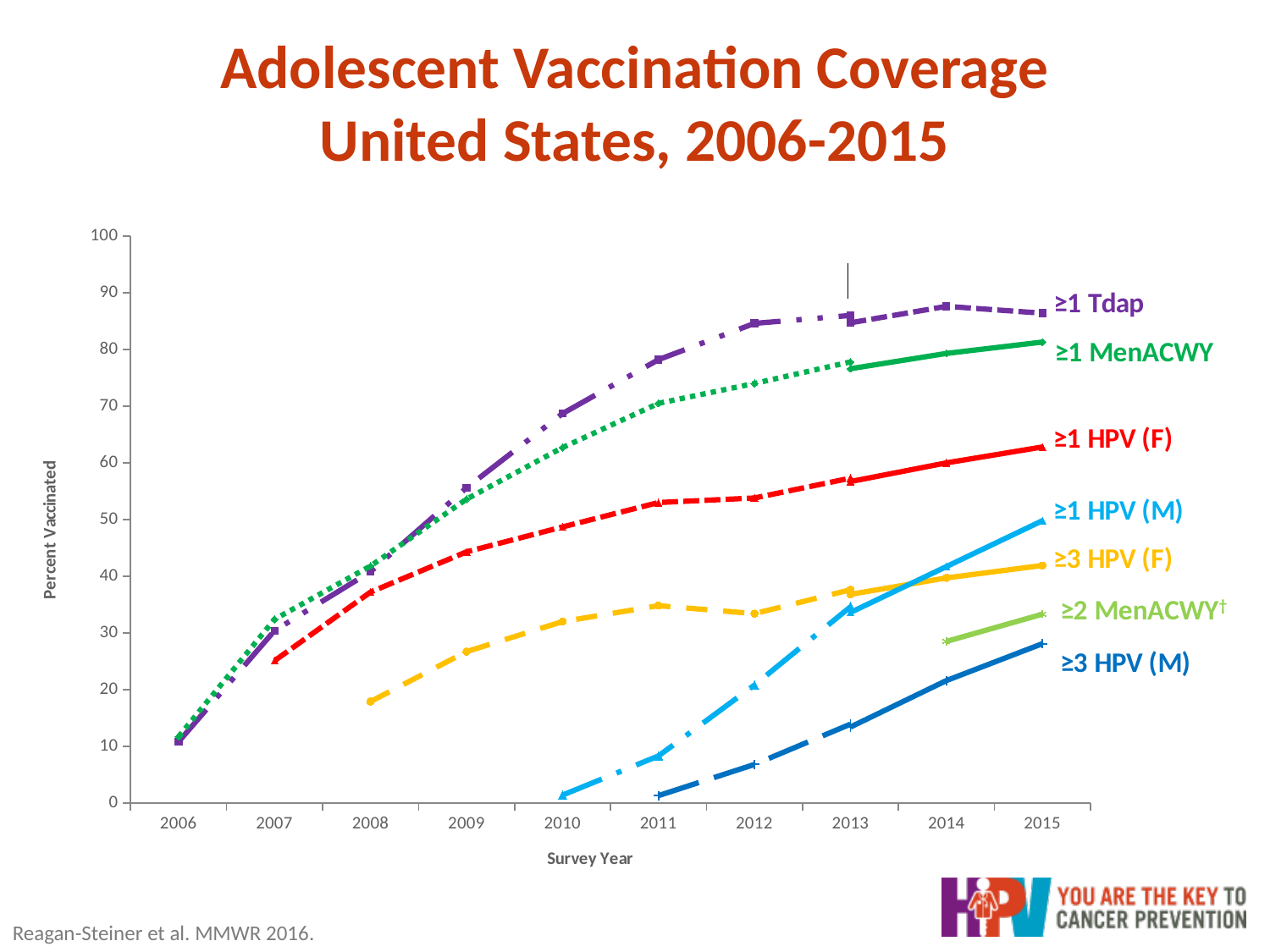
In 2015, which is larger: ≥1 HPV (M) or ≥3 HPV (F)? ≥1 HPV (M) Is the value for ≥1 Tdap in 2015 greater or less than 80? greater Does the ≥1 HPV (M) series rise or fall from 2010 to 2015? rise Is the value for ≥1 HPV (F) in 2015 greater or less than 60? greater Is the value for ≥1 HPV (M) in 2010 greater or less than 10? less How many vaccination series are labelled on the chart? 7 Which series has the highest value in 2015? ≥1 Tdap What is the label of the y axis? Percent Vaccinated Which series has the lowest value in 2015? ≥3 HPV (M) What kind of chart is shown on the slide? line chart How many survey years are shown on the x axis? 10